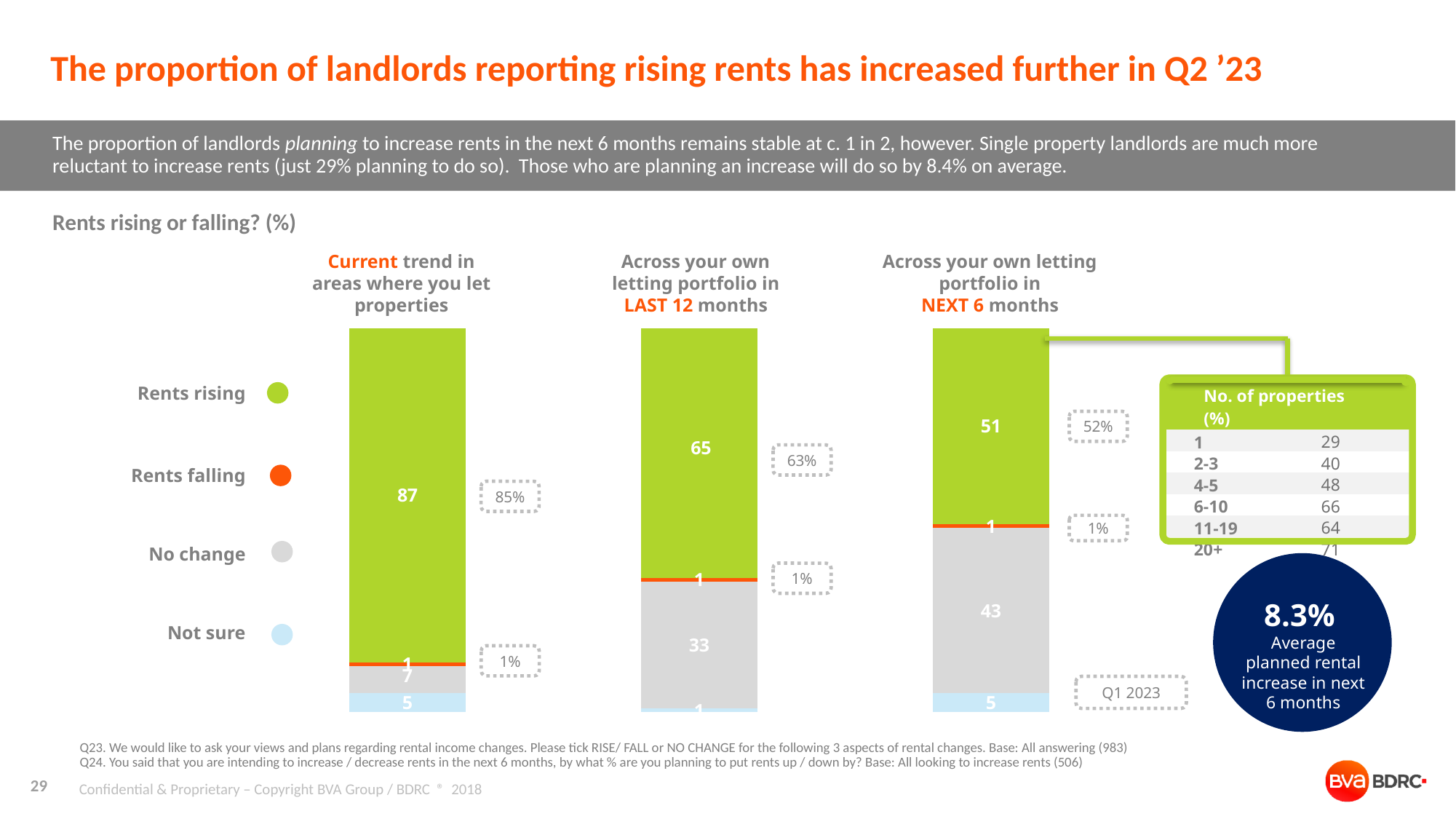
In the 'Current trend in areas where you let properties' bar, what is the value for Rents rising? 87 What colour represents Rents falling in the legend? Orange What was the Q1 2023 value for Rents rising in the 'Current trend in areas where you let properties' bar, shown in the dashed box? 85% In the 'NEXT 6 months' bar, which is larger: Rents rising or No change? Rents rising In the 'Across your own letting portfolio in NEXT 6 months' bar, what is the value for Rents rising? 51 In the 'Across your own letting portfolio in LAST 12 months' bar, what is the value for No change? 33 What is the difference between the Rents rising value in the 'Current trend' bar and the Rents rising value in the 'LAST 12 months' bar? 22 In the 'Across your own letting portfolio in NEXT 6 months' bar, what is the value for No change? 43 Which of the three bars has the lowest value for Rents rising? Across your own letting portfolio in NEXT 6 months What kind of chart is used to show 'Rents rising or falling? (%)'? Stacked bar chart Which of the three bars has the highest value for Rents rising? Current trend in areas where you let properties How many series does the legend list? 4